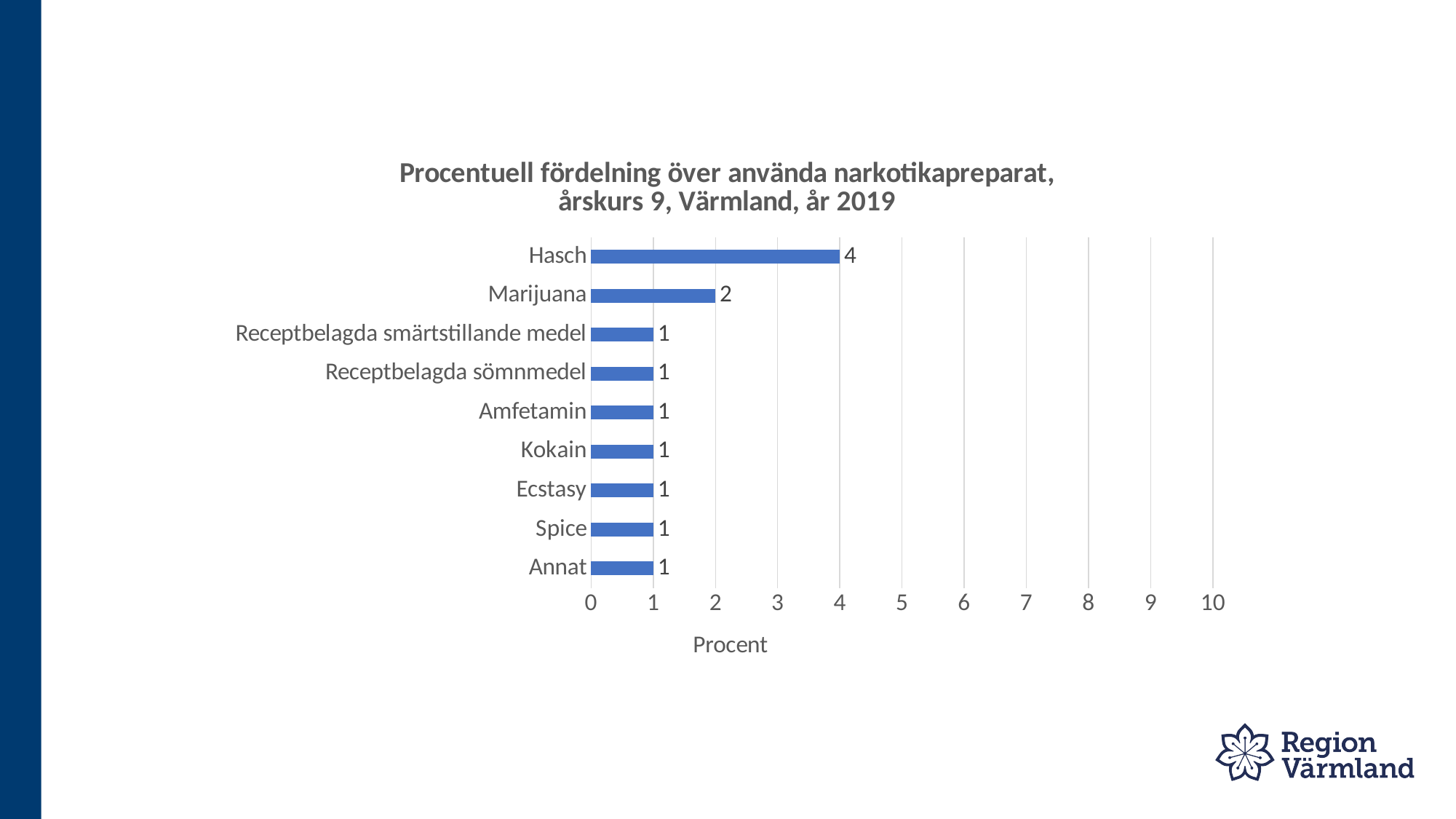
Which category has the highest value? Hasch What is the value for Marijuana? 2 How many categories are shown in the chart? 9 Which is larger, the value for Marijuana or the value for Ecstasy? Marijuana What is the value for Receptbelagda sömnmedel? 1 What is the highest value shown on the horizontal axis? 10 What is the value for Hasch? 4 What is the value for Kokain? 1 What is the label of the horizontal axis? Procent What is the difference between the values for Hasch and Marijuana? 2 What kind of chart is shown on the slide? bar chart Is the value for Hasch greater or less than 3? greater